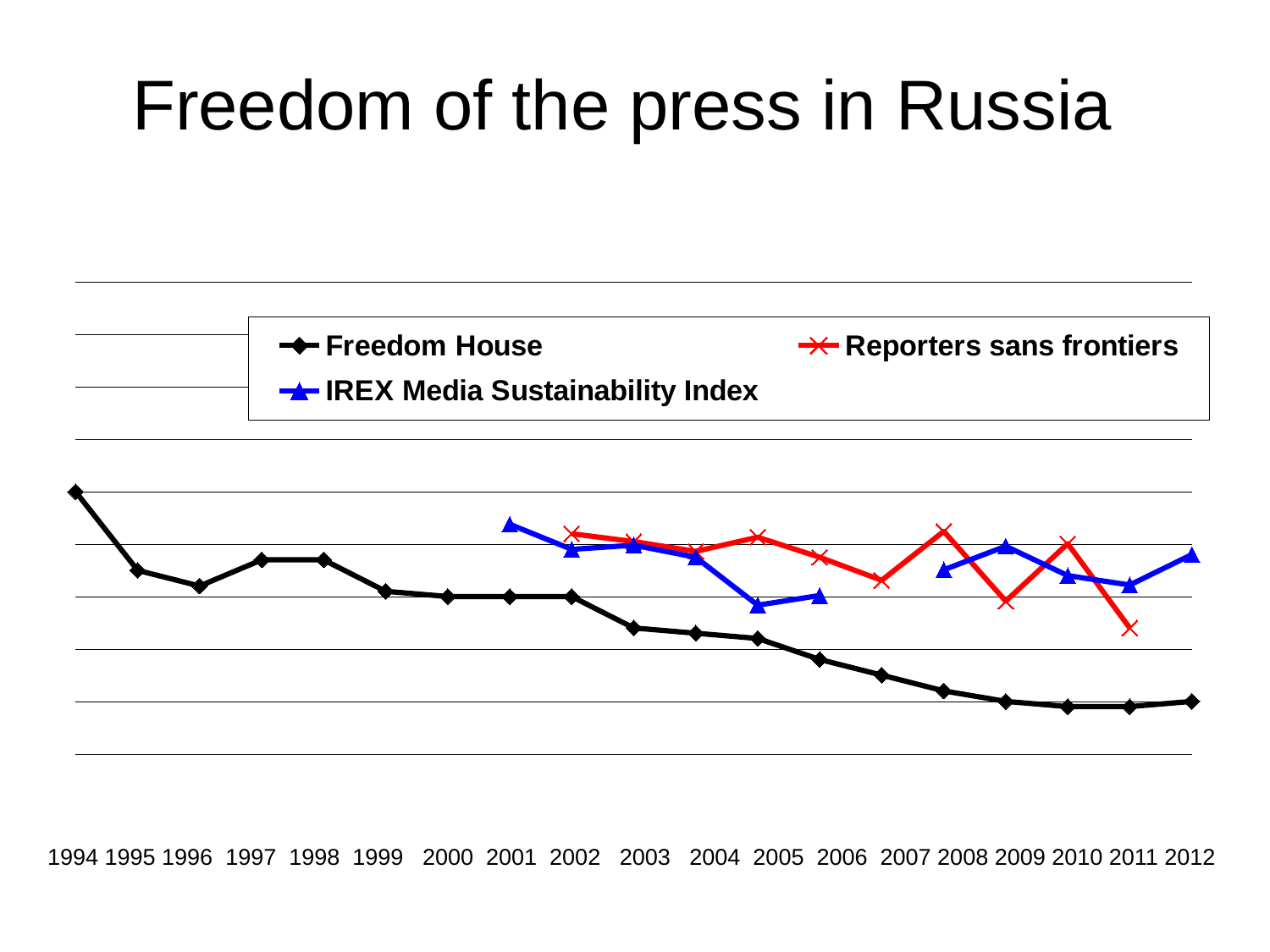
In which year is the Reporters sans frontiers series at its lowest? 2011 How many years are shown along the x axis? 19 In which year is the IREX Media Sustainability Index series at its lowest? 2005 In which year is the Freedom House series at its highest? 1994 Which series is drawn in red? Reporters sans frontiers In which year is the IREX Media Sustainability Index series at its highest? 2001 Which is larger for Freedom House: the value in 1994 or the value in 2012? 1994 How many series does the legend list? 3 What kind of chart is shown on the slide? line chart Does the Freedom House series rise or fall overall from 1994 to 2012? fall What is the title of the chart? Freedom of the press in Russia Which is larger for Reporters sans frontiers: the value in 2008 or the value in 2011? 2008